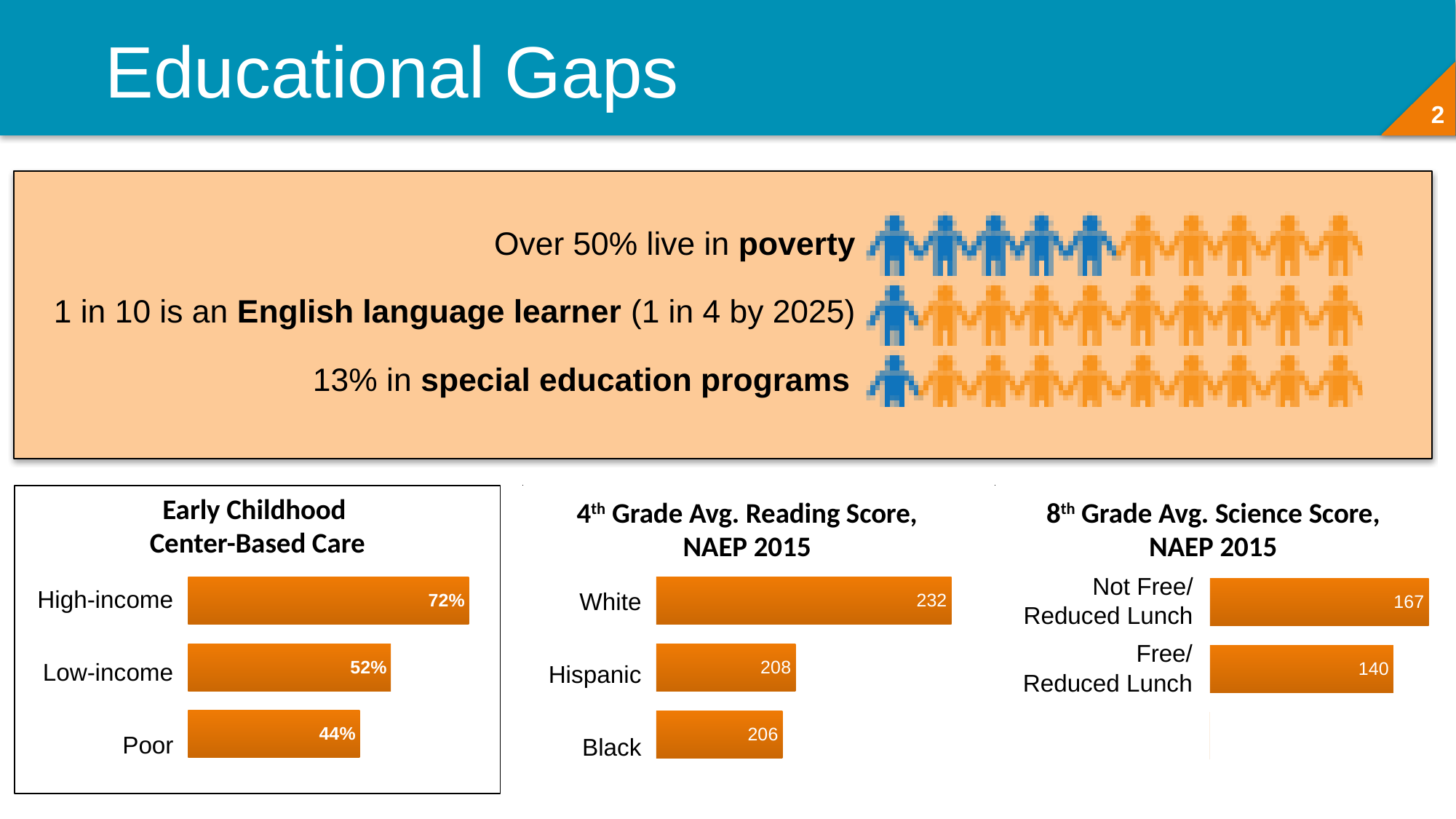
In the 8th Grade Avg. Science Score, NAEP 2015 chart, what is the value for Free/Reduced Lunch? 140 In the 4th Grade Avg. Reading Score, NAEP 2015 chart, what is the value for Hispanic? 208 How many categories does the 8th Grade Avg. Science Score, NAEP 2015 chart show? 2 In the Early Childhood Center-Based Care chart, what is the difference between the High-income and Poor values? 28% In the 4th Grade Avg. Reading Score, NAEP 2015 chart, what is the difference between the White and Black scores? 26 In the Early Childhood Center-Based Care chart, what is the value for Low-income? 52% In the Early Childhood Center-Based Care chart, which category has the lowest value? Poor What kind of chart is the 4th Grade Avg. Reading Score, NAEP 2015 chart? Bar chart In the 8th Grade Avg. Science Score, NAEP 2015 chart, what is the difference between the two scores? 27 In the 8th Grade Avg. Science Score, NAEP 2015 chart, which is larger, Not Free/Reduced Lunch or Free/Reduced Lunch? Not Free/Reduced Lunch In the 4th Grade Avg. Reading Score, NAEP 2015 chart, which category has the highest score? White How many categories does the Early Childhood Center-Based Care chart show? 3